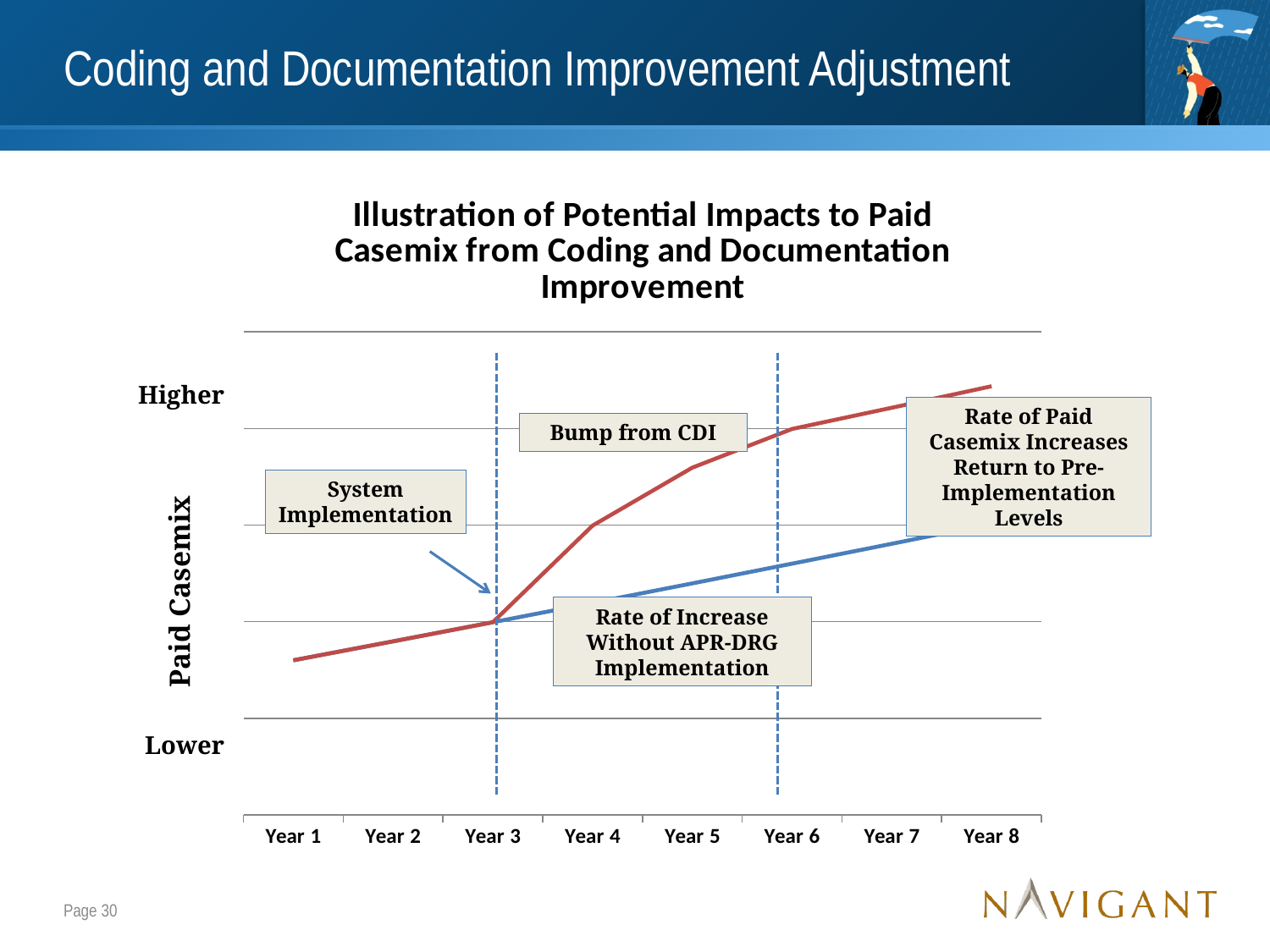
What is the title of the chart? Illustration of Potential Impacts to Paid Casemix from Coding and Documentation Improvement How many lines are plotted on the chart? 2 At Year 8, which line is higher, the red line or the blue line? The red line What is the label on the vertical axis of the chart? Paid Casemix How many years are labelled along the x axis of the chart? 8 Does the red line rise or fall from Year 1 to Year 8? Rise Which year is labelled last on the x axis? Year 8 Which year is labelled first on the x axis? Year 1 Does the blue line rise or fall from Year 3 to Year 8? Rise At which year does the red line diverge from the blue line? Year 3 At Year 5, which line shows a higher paid casemix, the red line or the blue line? The red line What kind of chart is shown on the slide? Line chart